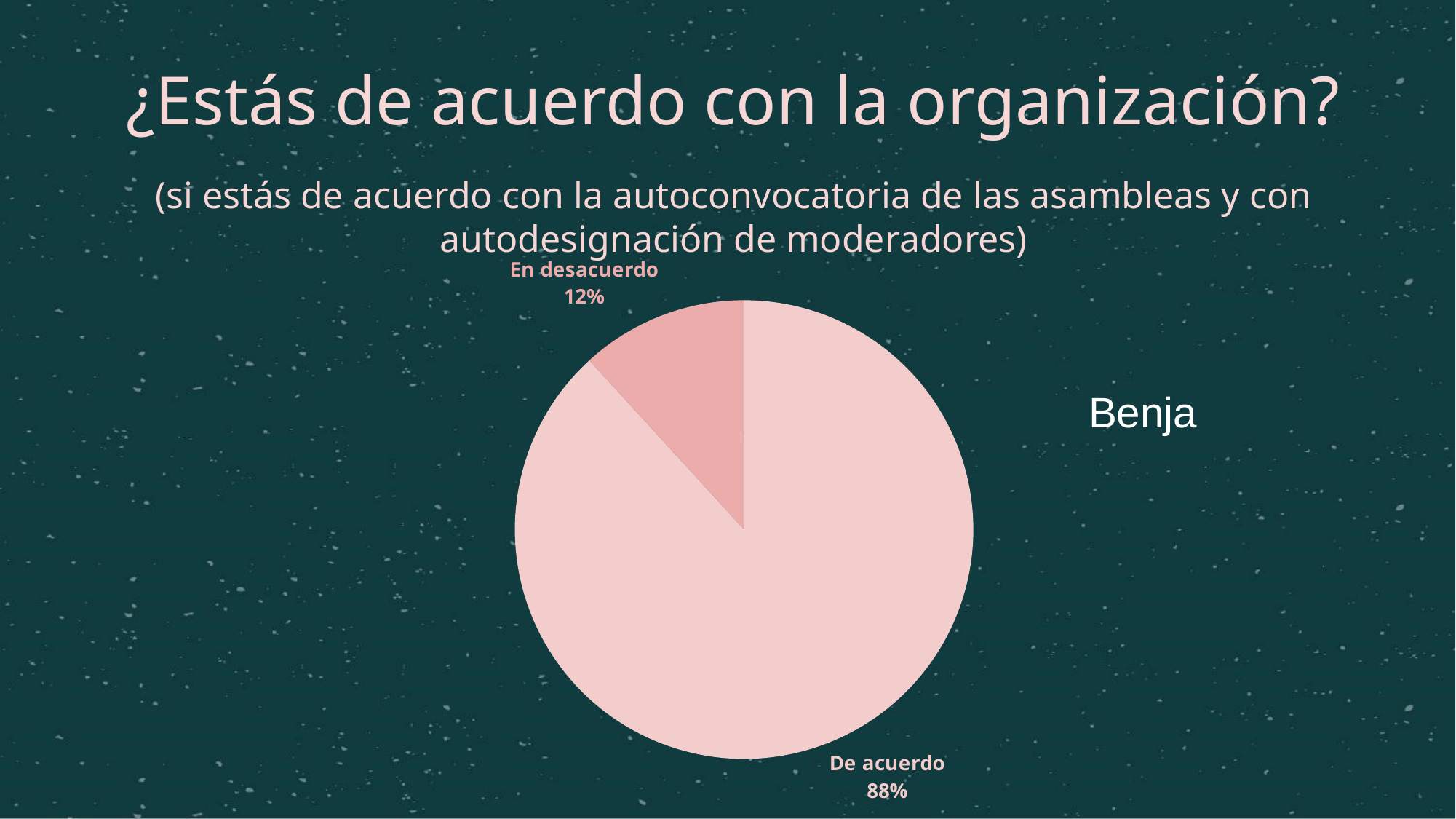
What is the title of the slide containing the pie chart? ¿Estás de acuerdo con la organización? Which slice of the pie is the largest? De acuerdo Which is larger, the "De acuerdo" slice or the "En desacuerdo" slice? De acuerdo What share of the pie does "En desacuerdo" represent? 12% What name appears to the right of the pie chart? Benja What share of the pie does "De acuerdo" represent? 88% What is the difference in percentage points between "De acuerdo" and "En desacuerdo"? 76 How many slices does the pie chart have? 2 Which slice of the pie is the smallest? En desacuerdo What kind of chart is shown on the slide? pie chart What is the total of the two percentages shown on the pie chart? 100%